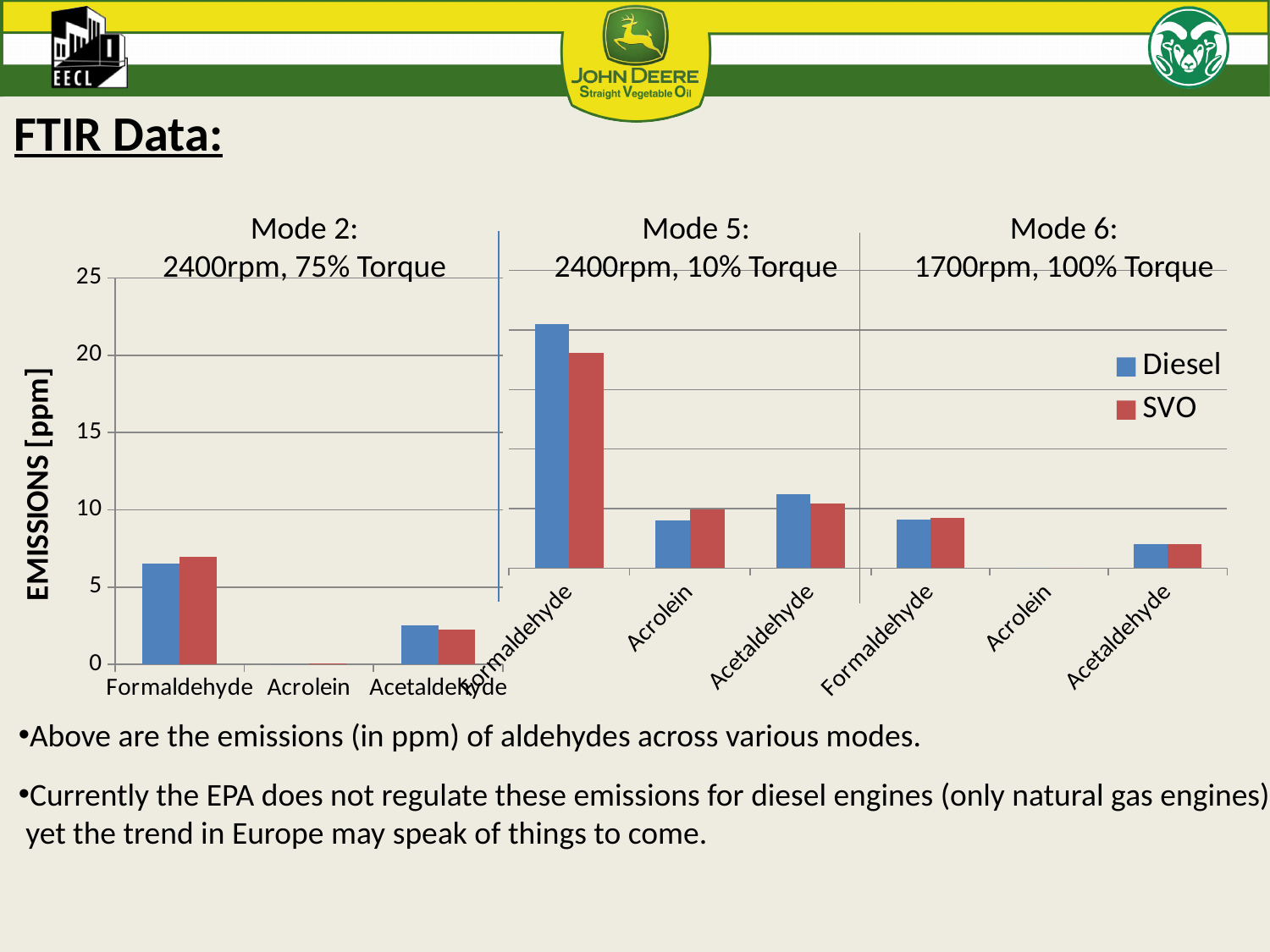
How many aldehyde categories are plotted for each mode? 3 What kind of chart is shown on the slide? bar chart What is the label on the vertical axis of the chart? EMISSIONS [ppm] How many engine modes are shown in the chart? 3 Is the SVO value for Formaldehyde in Mode 5 greater or less than 15? greater How many series does the chart legend list? 2 For Formaldehyde in Mode 5, which series has the larger value, Diesel or SVO? Diesel Which mode and compound has the highest Diesel emission bar in the chart? Formaldehyde in Mode 5 Is the Diesel value for Formaldehyde in Mode 2 greater or less than 10? less What are the two series named in the chart legend? Diesel and SVO Which compound has the lowest emissions in Mode 6? Acrolein